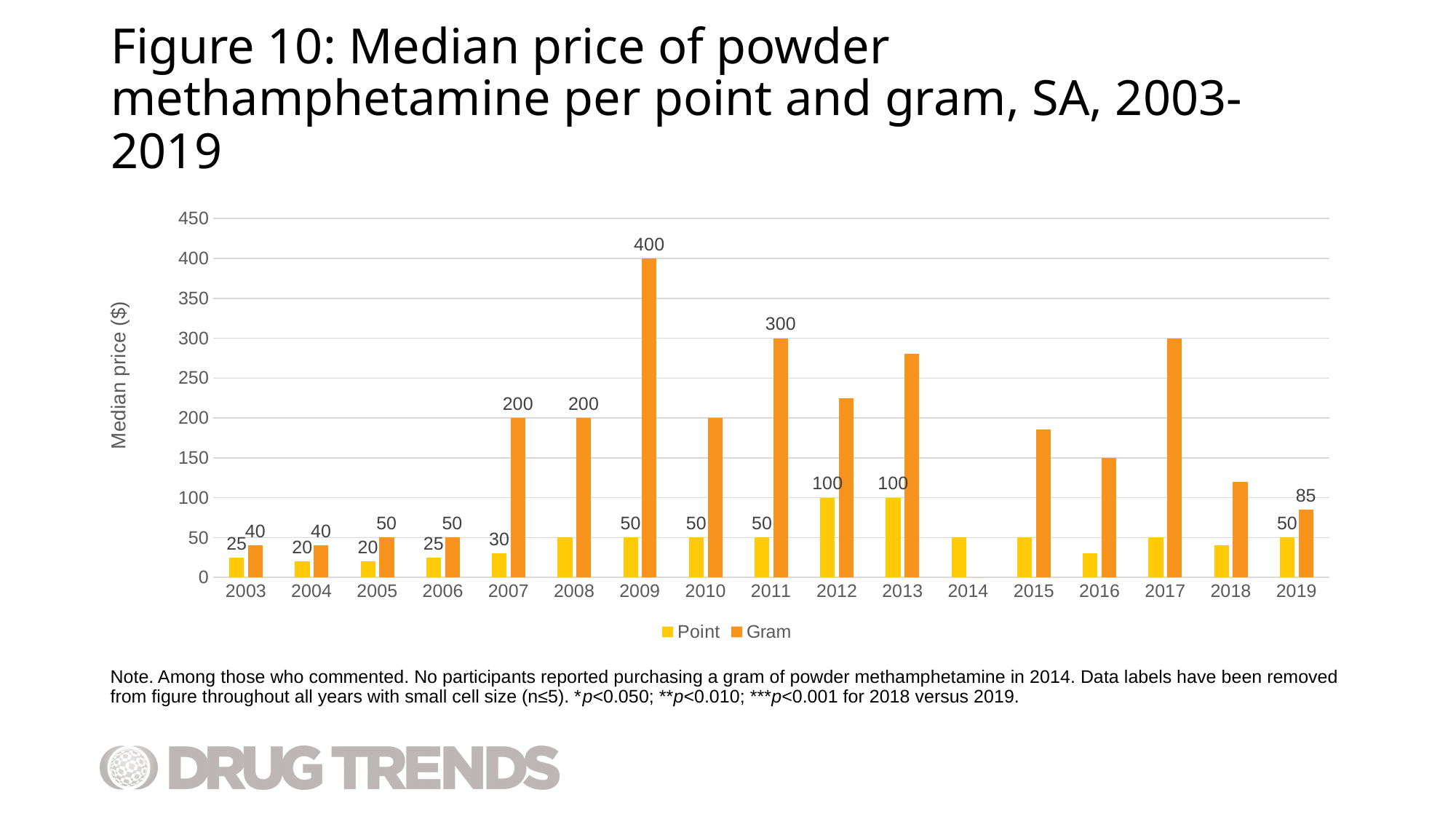
What is the median price per point in 2012? 100 How many series does the legend list? 2 What is the median price per point in 2007? 30 How many years are shown on the x axis? 17 Is the median price per gram in 2017 greater or less than 250? greater What is the difference between the median price per gram and per point in 2019? 35 In which year is the median price per gram highest? 2009 What is the median price per gram in 2009? 400 Is the median price per gram in 2016 greater or less than 200? less What is the median price per gram in 2019? 85 Which is larger, the median price per gram in 2009 or in 2011? 2009 What is the difference between the median price per gram in 2009 and in 2011? 100